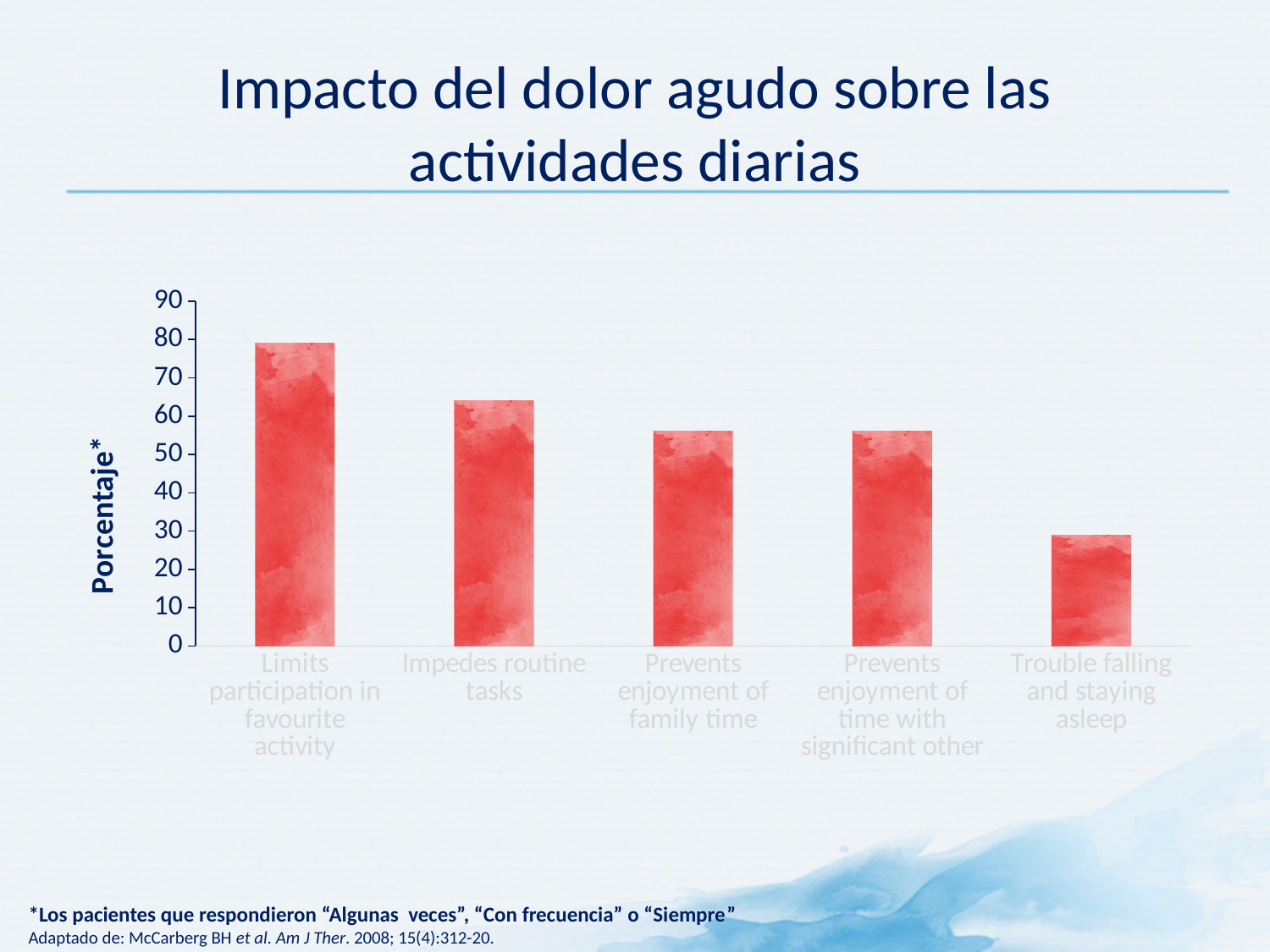
How many categories are plotted on the x axis? 5 Is the value for 'Prevents enjoyment of family time' greater or less than 60? less Which category has the lowest value? Trouble falling and staying asleep What is the label on the vertical axis of the chart? Porcentaje* Which is larger: the value for 'Limits participation in favourite activity' or the value for 'Impedes routine tasks'? Limits participation in favourite activity Do the values generally rise or fall from left to right along the x axis? fall Which category has the highest value? Limits participation in favourite activity Is the value for 'Trouble falling and staying asleep' greater or less than 40? less Is the value for 'Impedes routine tasks' greater or less than 60? greater Which is larger: the value for 'Impedes routine tasks' or the value for 'Trouble falling and staying asleep'? Impedes routine tasks What kind of chart is shown on the slide? bar chart